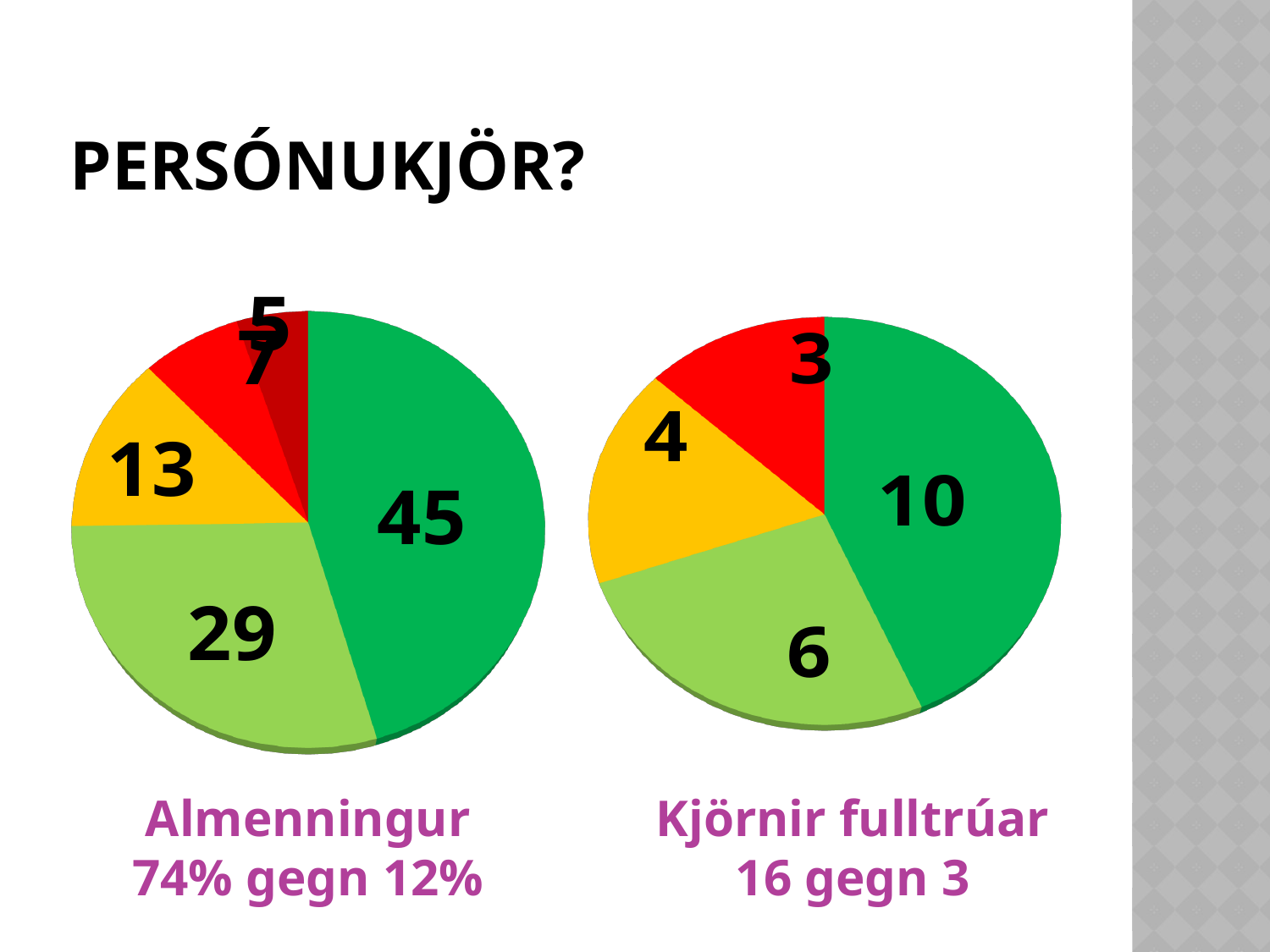
In the right chart "Kjörnir fulltrúar", what is the value of the yellow slice? 4 In the right chart "Kjörnir fulltrúar", what is the total of all the slice values? 23 In the left chart "Almenningur", what is the value of the light green slice? 29 In the right chart "Kjörnir fulltrúar", what is the value of the dark green slice? 10 In the right chart "Kjörnir fulltrúar", what is the value of the largest slice? 10 In the right chart "Kjörnir fulltrúar", how many slices does the pie have? 4 In the left chart "Almenningur", what is the difference between the dark green slice (45) and the light green slice (29)? 16 In the right chart "Kjörnir fulltrúar", what is the value of the smallest slice? 3 What kind of chart is the left chart labelled "Almenningur"? pie chart In the left chart "Almenningur", which slice is larger, the yellow slice or the red slice? the yellow slice In the left chart "Almenningur", what is the value of the largest slice? 45 What text is shown beneath the left pie chart? Almenningur 74% gegn 12%